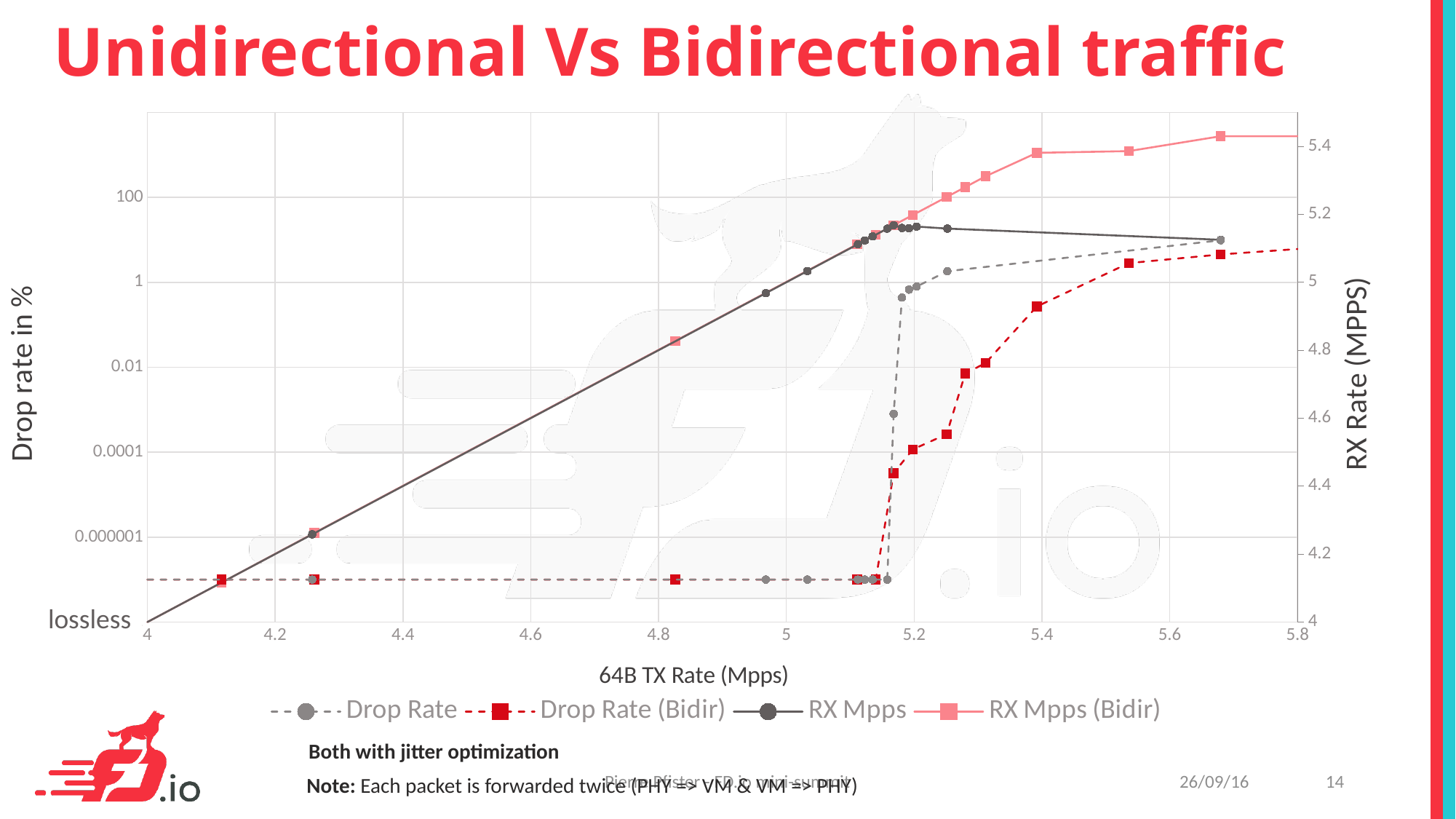
Is the Drop Rate value at a TX rate of 5.6 greater or less than 1%? greater Is the RX Mpps value at the highest plotted TX rate (around 5.7) greater or less than 5.2 Mpps? less What is the title of the slide's chart? Unidirectional Vs Bidirectional traffic Is the Drop Rate (Bidir) value at a TX rate of 5.4 greater or less than 1%? less At a TX rate of 5.4, which series has the higher RX rate: RX Mpps or RX Mpps (Bidir)? RX Mpps (Bidir) Does the RX Mpps (Bidir) series rise or fall as the TX rate increases along the x axis? rise What is the label of the x axis? 64B TX Rate (Mpps) How many series does the legend list? 4 What kind of chart is shown on the slide? line chart At a TX rate of 5.4, which series has the higher drop rate: Drop Rate or Drop Rate (Bidir)? Drop Rate Which series reaches the highest RX rate on the chart? RX Mpps (Bidir)